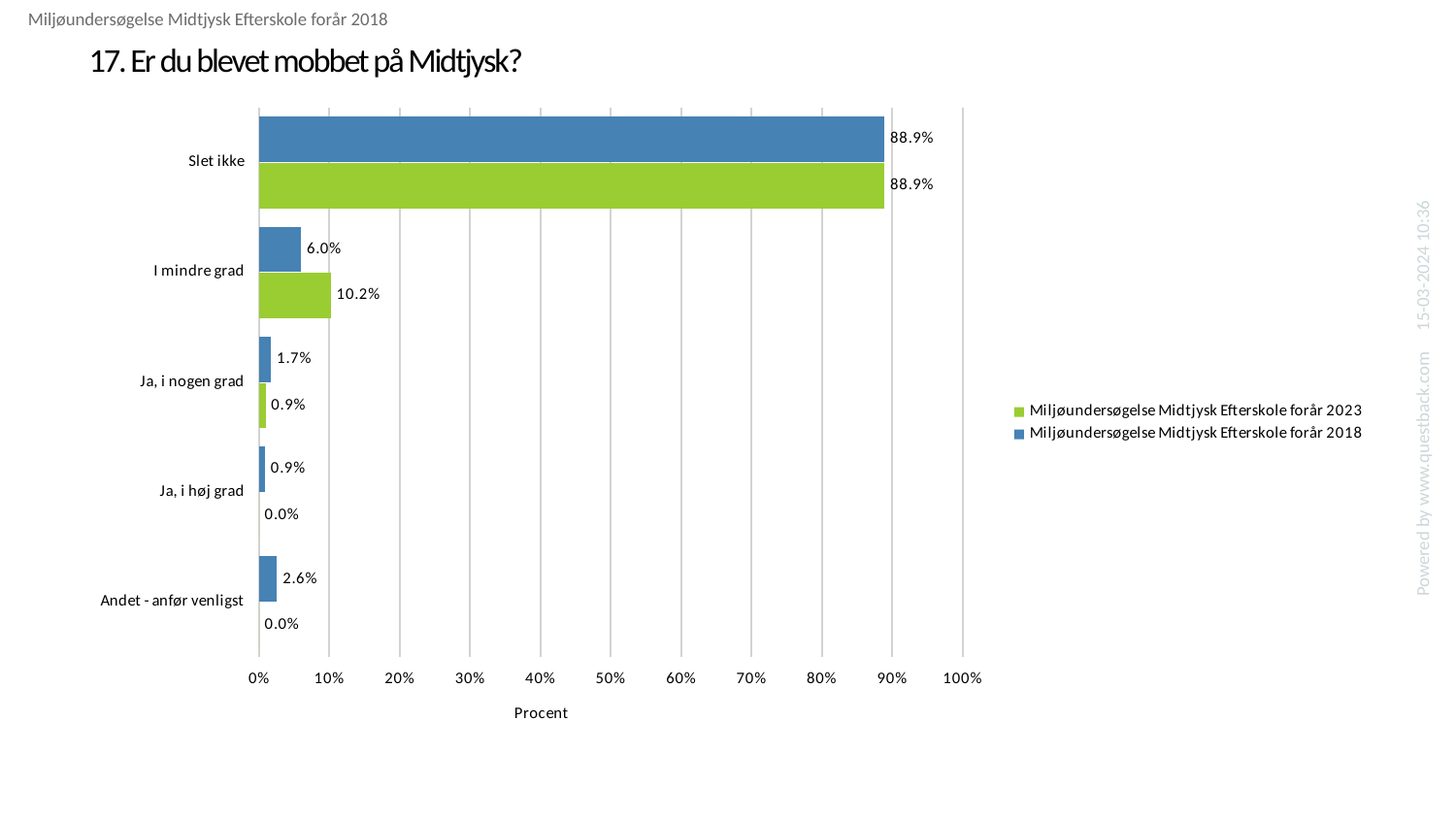
What is the value for 'I mindre grad' in the 2018 survey (Miljøundersøgelse Midtjysk Efterskole forår 2018)? 6.0% Is the value for 'Slet ikke' in the 2018 survey greater or less than 80%? greater What is the value for 'I mindre grad' in the 2023 survey (Miljøundersøgelse Midtjysk Efterskole forår 2023)? 10.2% Which category has the highest value in the 2023 survey? Slet ikke What is the value for 'Ja, i høj grad' in the 2023 survey? 0.0% What is the label of the x axis? Procent How many answer categories are shown on the chart? 5 What is the difference between the 2023 and 2018 values for 'I mindre grad'? 4.2% For 'Ja, i nogen grad', which survey has the larger value, 2018 or 2023? 2018 What type of chart is shown on the slide? Bar chart What is the value for 'Andet - anfør venligst' in the 2018 survey? 2.6% How many series does the legend list? 2